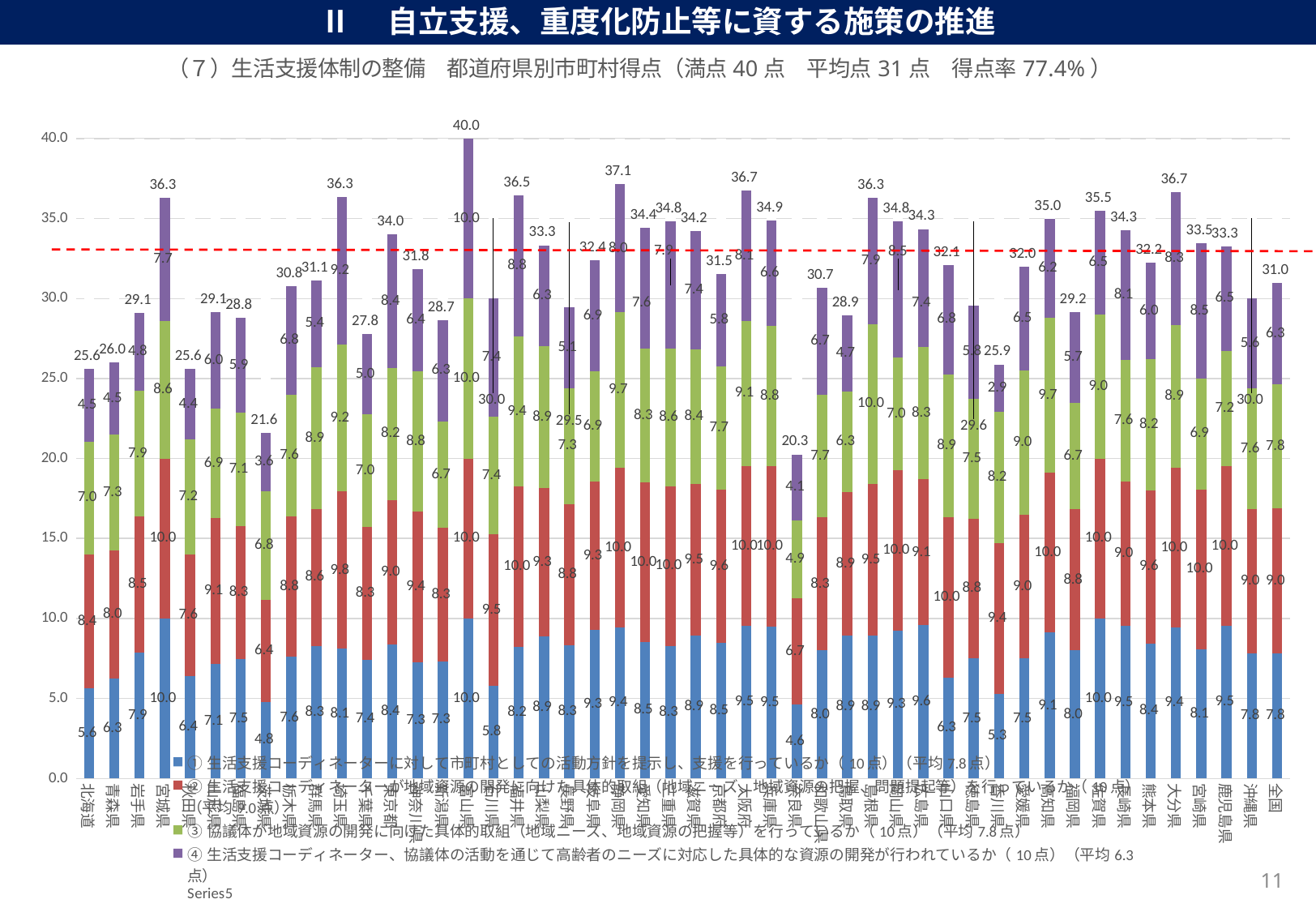
How many series does the legend list? 5 What is the total score shown for 鹿児島県? 33.3 What kind of chart is shown on the slide? stacked bar chart What is the total score shown for 全国? 31.0 What is the highest total score labeled on the chart? 40.0 What is the total score shown for 宮城県? 36.3 Which has a higher total score, 宮城県 or 青森県? 宮城県 What is the total score shown for 北海道? 25.6 What is the difference between the total scores of 宮城県 and 北海道? 10.7 What is the total score shown for 大分県? 36.7 What is the value of the blue (①) segment for 北海道? 5.6 What is the value of the red (②) segment for 全国? 9.0